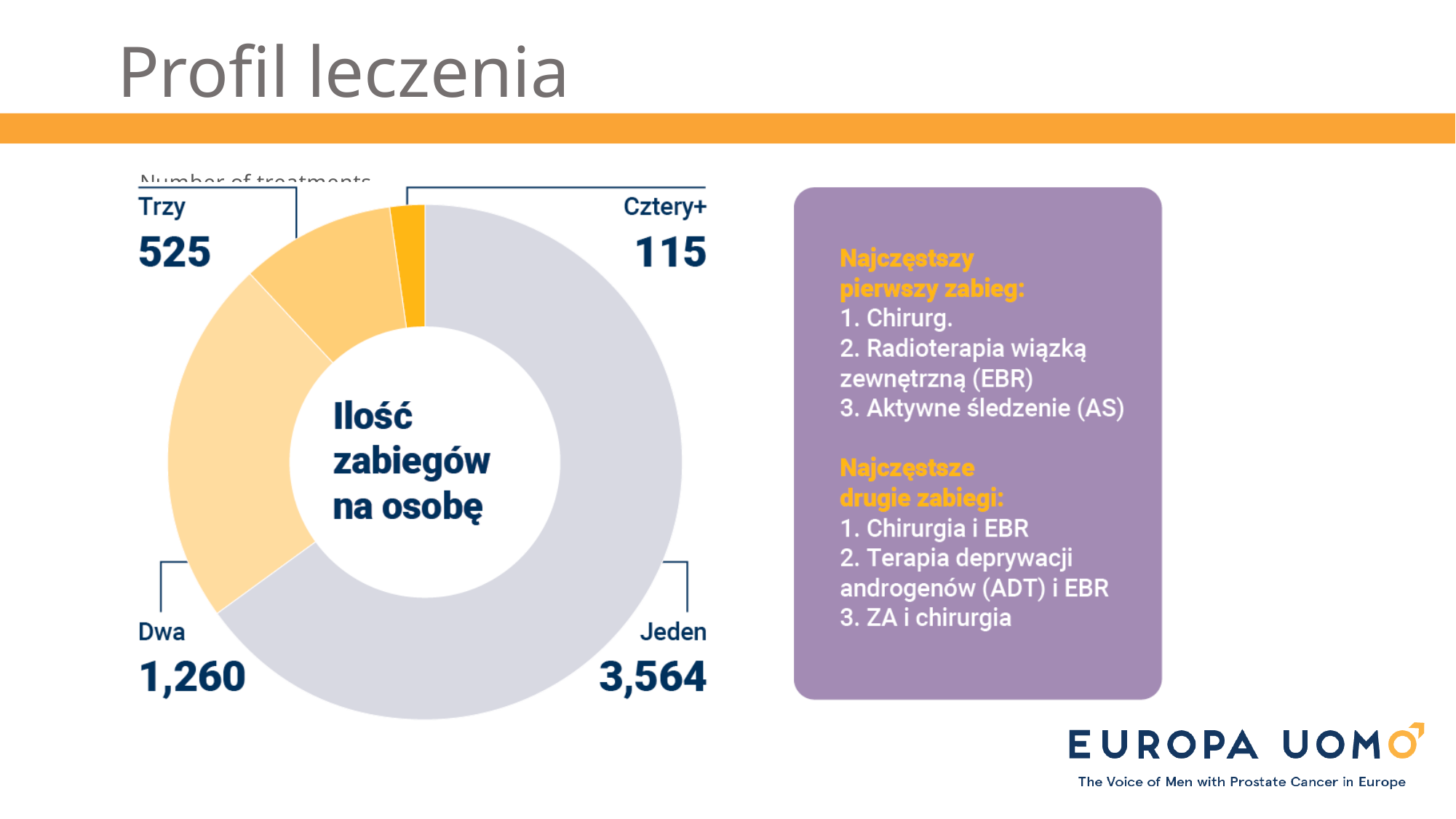
Which segment of the donut chart has the lowest value? Cztery+ What is the value for the 'Cztery+' segment? 115 What is the difference between the 'Jeden' and 'Dwa' values? 2,304 What is the value for the 'Trzy' segment? 525 What is the value for the 'Dwa' segment? 1,260 What is the value for the 'Jeden' segment? 3,564 Which segment of the donut chart has the highest value? Jeden What text is written in the centre of the donut chart? Ilość zabiegów na osobę How many segments does the donut chart have? 4 Which is larger, the value for 'Dwa' or the value for 'Trzy'? Dwa What is the difference between the 'Trzy' and 'Cztery+' values? 410 What kind of chart is shown on the slide? Donut (pie) chart